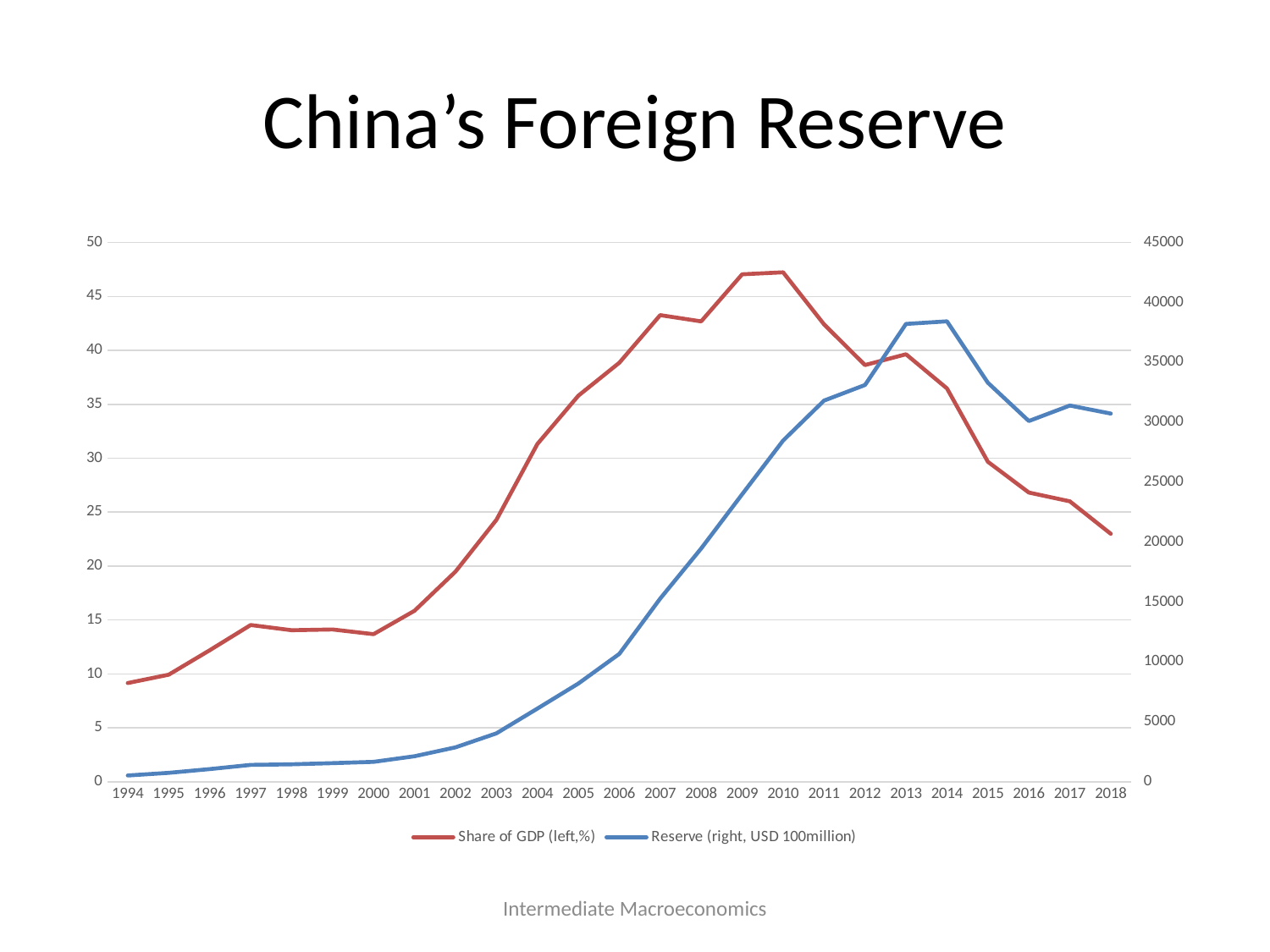
Is the Reserve value for 2005 greater or less than 10000? less Is the Share of GDP value for 2000 greater or less than 15? less Is the Share of GDP value for 2018 greater or less than 20? greater How many series does the legend list? 2 What is the title of the chart? China's Foreign Reserve Does the Share of GDP series rise or fall from 2010 to 2018? fall What kind of chart is shown on the slide? line chart Which series is plotted against the right-hand axis? Reserve (right, USD 100million) In which year is the Share of GDP series at its lowest? 1994 How many years are plotted along the x axis? 25 In which year is the Reserve series at its lowest? 1994